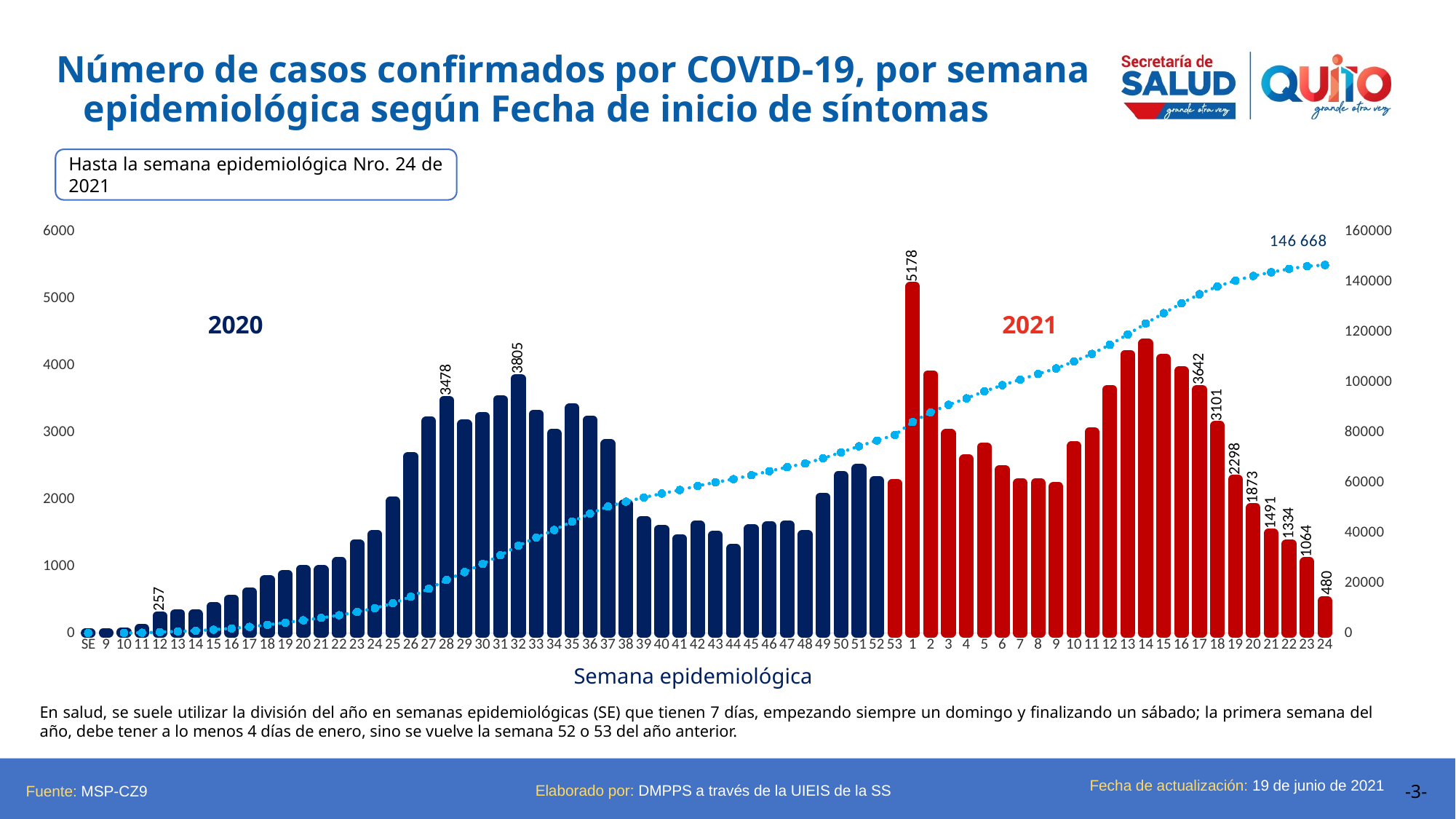
What is the number of confirmed cases for epidemiological week 24 of 2021? 480 Is the value for week 39 of 2020 greater or less than 2000? less What is the difference between the cases in week 1 of 2021 and week 32 of 2020? 1373 What is the number of confirmed cases for epidemiological week 1 of 2021? 5178 What is the number of confirmed cases for epidemiological week 32 of 2020? 3805 Is the value for week 14 of 2021 greater or less than 4000? greater Which epidemiological week has the highest number of confirmed cases? Week 1 of 2021 What is the final value shown for the dotted cumulative line at week 24 of 2021? 146 668 Which is larger: the cases in week 17 of 2021 or week 32 of 2020? Week 32 of 2020 From week 17 to week 24 of 2021, do the weekly case values rise or fall? fall What colour are the bars for the year 2021? Red What is the difference between the cases in week 32 of 2020 and week 28 of 2020? 327